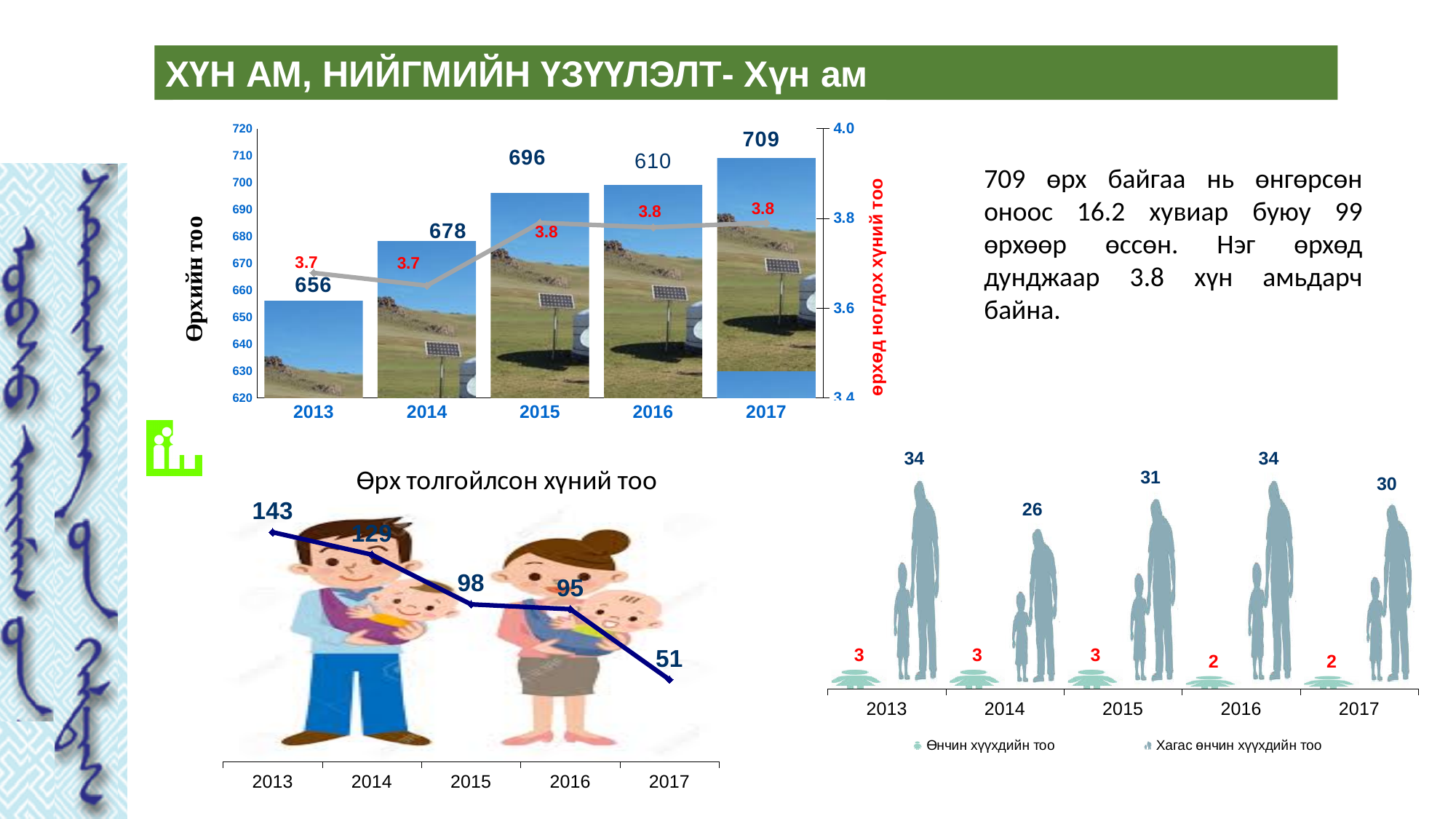
In the top-left chart, what is the number of households for 2013? 656 In the bottom-right chart, what is the value of 'Хагас өнчин хүүхдийн тоо' for 2014? 26 In the top-left chart, what is the difference between the number of households in 2017 and in 2013? 53 In the top-left chart, what is the average number of people per household (өрхөд ногдох хүний тоо) shown for 2015? 3.8 In the chart titled 'Өрх толгойлсон хүний тоо', do the values rise or fall from 2013 to 2017? fall In the chart titled 'Өрх толгойлсон хүний тоо', which year has the lowest value? 2017 In the top-left chart, which year has the highest number of households? 2017 In the chart titled 'Өрх толгойлсон хүний тоо', what is the value for 2013? 143 In the top-left chart, what is the number of households (Өрхийн тоо) for 2017? 709 In the top-left chart, how many years are shown on the x axis? 5 In the chart titled 'Өрх толгойлсон хүний тоо', what is the difference between the 2013 and 2017 values? 92 In the bottom-right chart, how many series does the legend list? 2